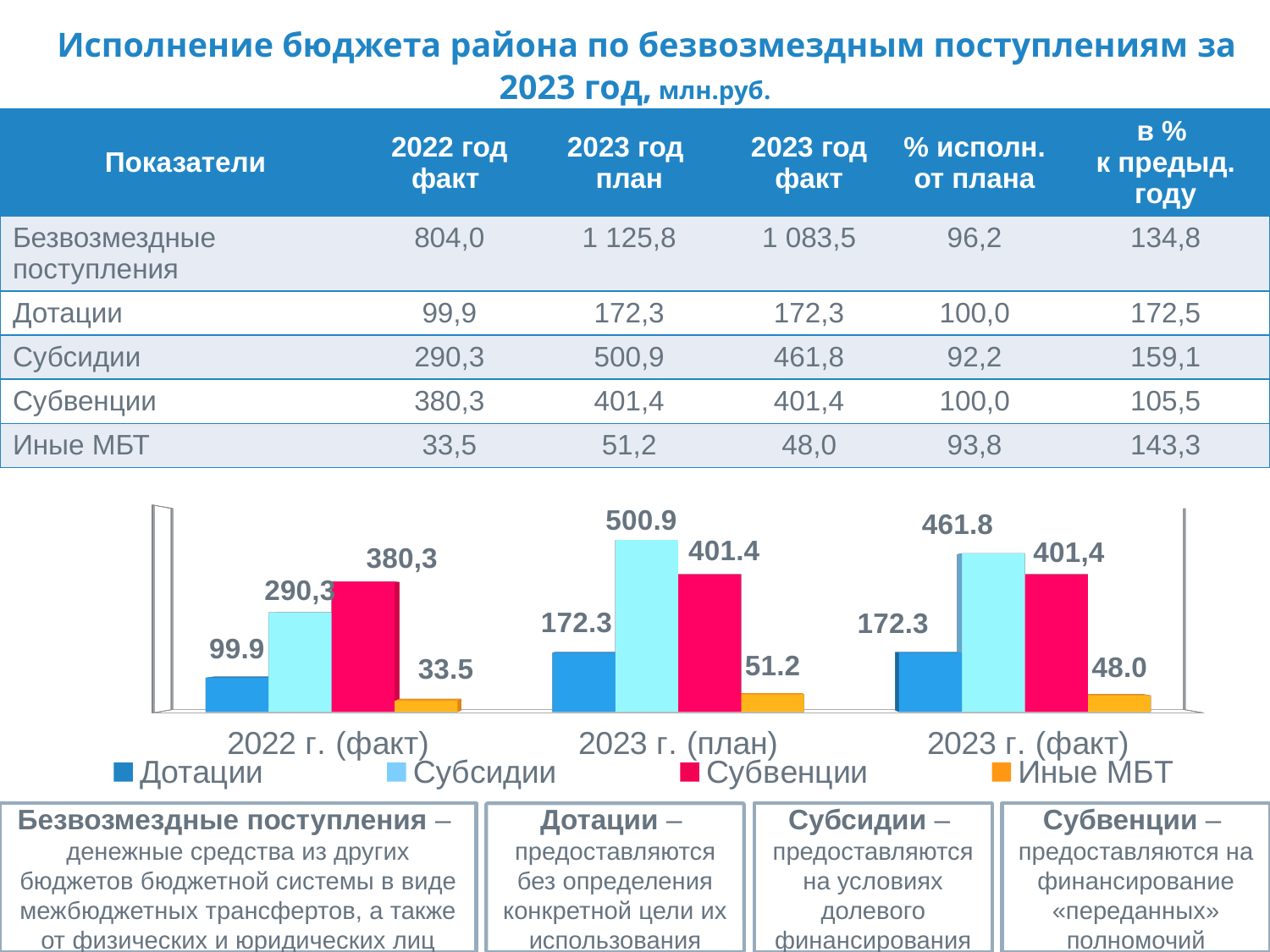
Which is larger in the 2022 г. (факт) group: Субсидии or Субвенции? Субвенции How many category groups are shown on the x axis of the chart? 3 What is the difference between Субсидии for 2023 г. (план) and Субсидии for 2023 г. (факт)? 39.1 Which series has the lowest value in the 2022 г. (факт) group? Иные МБТ What is the value of Субвенции for 2022 г. (факт) in the chart? 380,3 What kind of chart is shown on the slide? bar chart What is the value of Дотации for 2022 г. (факт) in the chart? 99.9 Which series has the highest value in the 2023 г. (факт) group? Субсидии What is the value of Субсидии for 2023 г. (план) in the chart? 500.9 Does the value of Дотации rise or fall from 2022 г. (факт) to 2023 г. (план)? rise What is the value of Иные МБТ for 2023 г. (факт) in the chart? 48.0 How many series does the chart legend list? 4